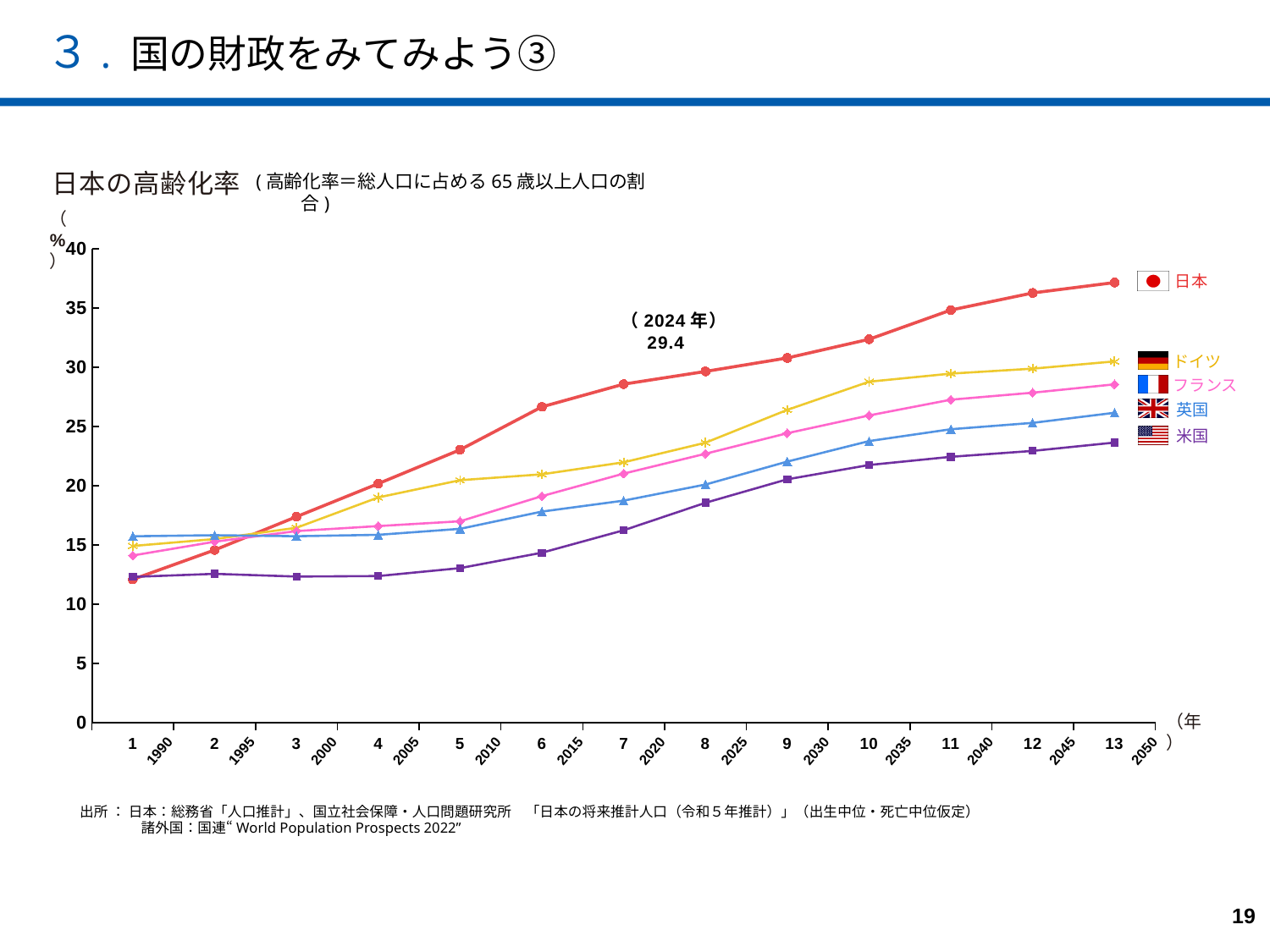
Which country has the highest value in 2050? 日本 What value is printed for 日本 (Japan) at 2024 on the chart? 29.4 Is the value for 日本 in 2050 greater or less than 35? greater Is the value for 米国 in 2050 greater or less than 25? less How many series does the legend list? 5 What is the title of the chart? 日本の高齢化率 Is the value for 日本 in 1990 greater or less than 15? less How many year points are plotted along the x axis? 13 Does the value for 日本 rise or fall from 1990 to 2050? rise In 2050, which is higher, ドイツ or フランス? ドイツ Which country has the lowest value in 2050? 米国 What kind of chart is shown on the slide? line chart